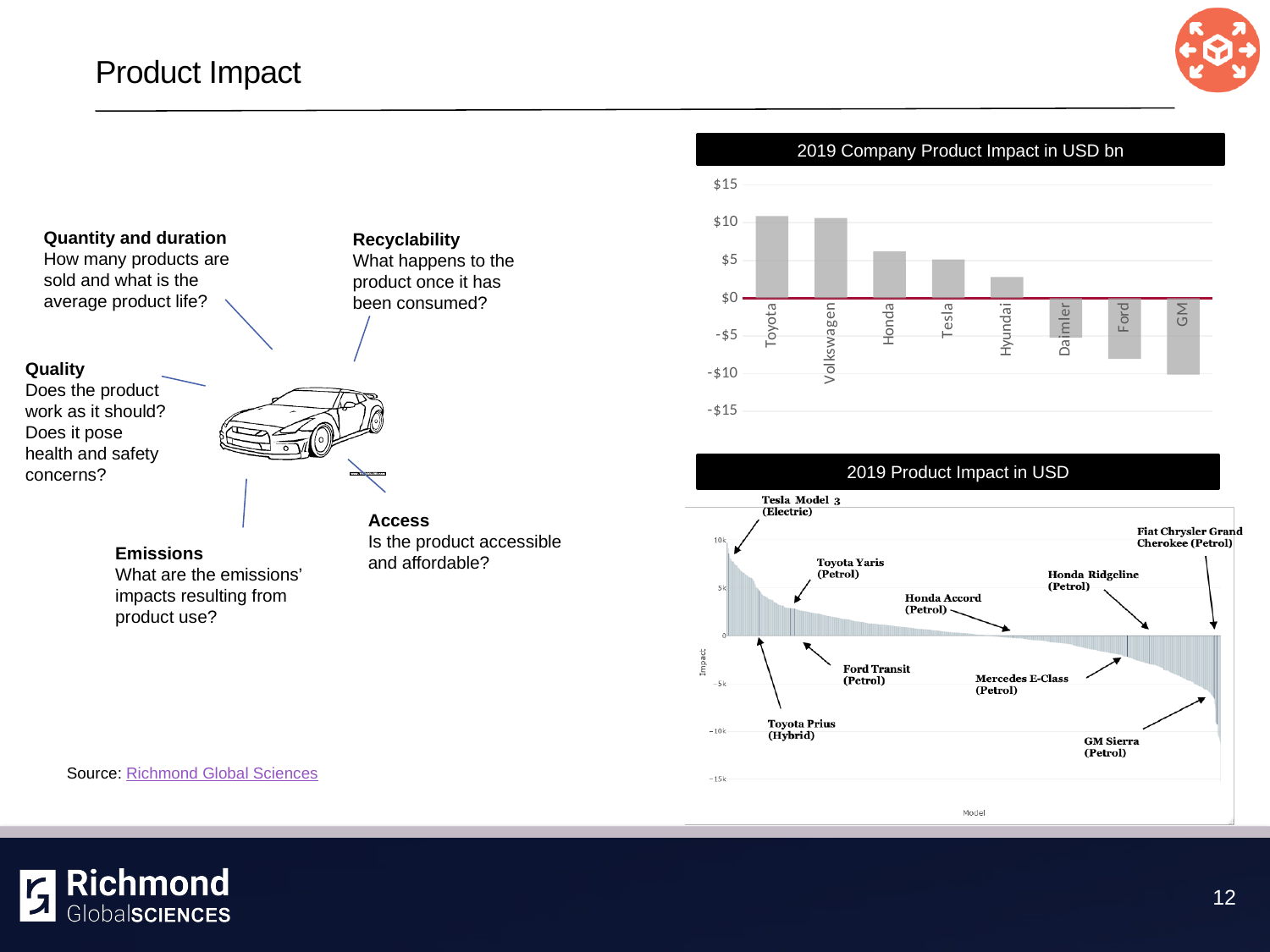
In the chart titled '2019 Company Product Impact in USD bn', do the values rise or fall from left to right along the x axis? Fall In the chart titled '2019 Product Impact in USD', which labelled model has the lowest impact? GM Sierra (Petrol) In the chart titled '2019 Product Impact in USD', which labelled model has the highest impact? Tesla Model 3 (Electric) In the chart titled '2019 Company Product Impact in USD bn', which company has the lowest product impact? GM What is the title of the lower chart on the slide? 2019 Product Impact in USD In the chart titled '2019 Company Product Impact in USD bn', is the value for Ford greater or less than -$5? less In the chart titled '2019 Company Product Impact in USD bn', which is larger, the value for Honda or the value for Hyundai? Honda What kind of chart is the one titled '2019 Company Product Impact in USD bn'? Bar chart In the chart titled '2019 Company Product Impact in USD bn', is the value for Hyundai greater or less than $5? less In the chart titled '2019 Company Product Impact in USD bn', how many companies are shown on the x axis? 8 In the chart titled '2019 Company Product Impact in USD bn', which is larger, the value for Ford or the value for GM? Ford In the chart titled '2019 Company Product Impact in USD bn', is the value for Honda greater or less than $5? greater